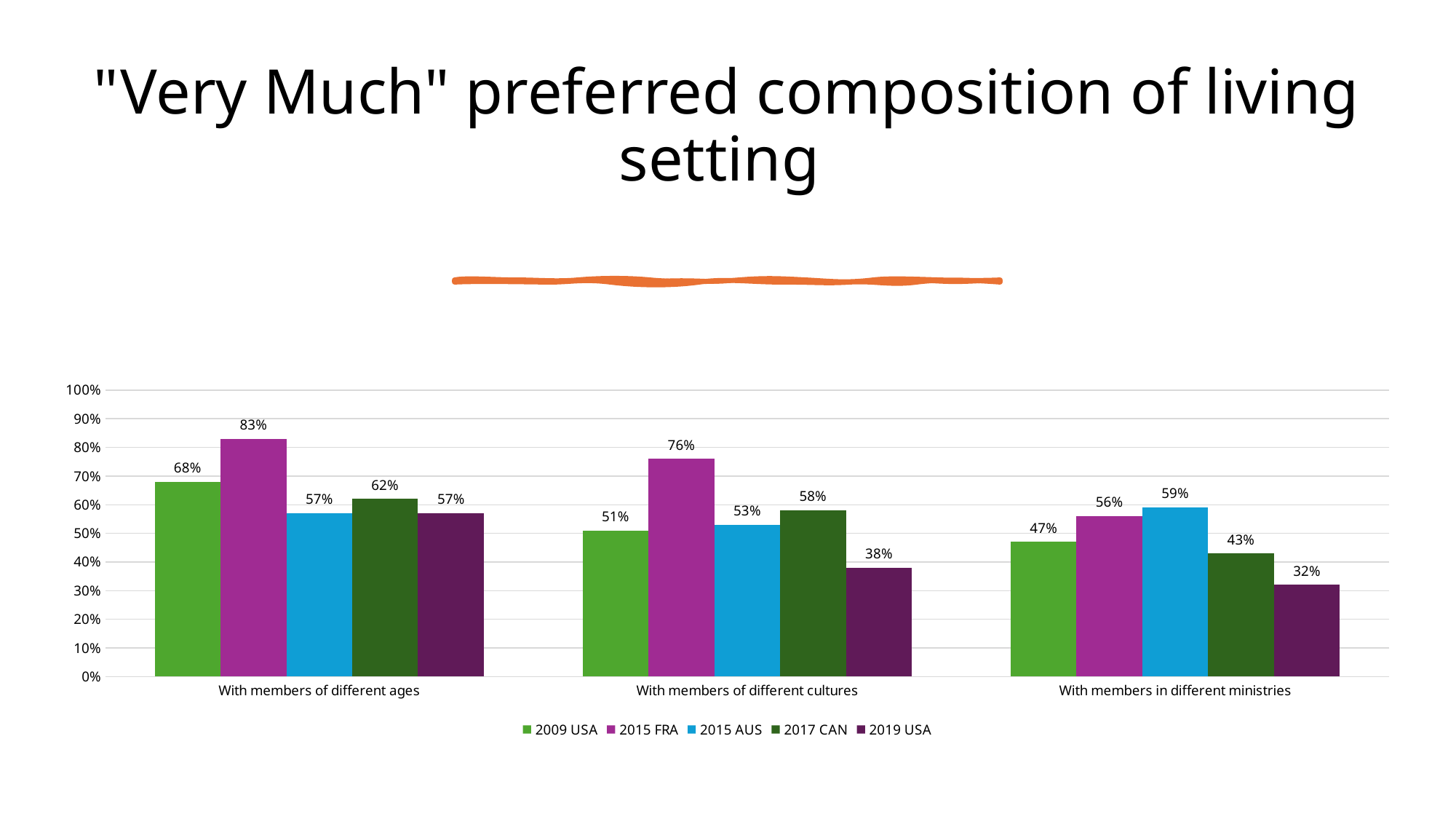
Which series has the highest value in the "With members in different ministries" category? 2015 AUS What is the value for 2015 FRA in the "With members of different ages" category? 83% How many categories are shown on the x axis? 3 What is the difference between the 2015 FRA and 2009 USA values in the "With members of different ages" category? 15% Which series has the lowest value in the "With members of different cultures" category? 2019 USA What kind of chart is shown on the slide? Bar chart Do the 2019 USA values rise or fall across the categories from left to right? Fall How many series does the legend list? 5 What is the value for 2019 USA in the "With members in different ministries" category? 32% What is the title of the chart on the slide? "Very Much" preferred composition of living setting What is the value for 2017 CAN in the "With members of different cultures" category? 58% Which is larger in the "With members of different cultures" category: 2009 USA or 2015 AUS? 2015 AUS